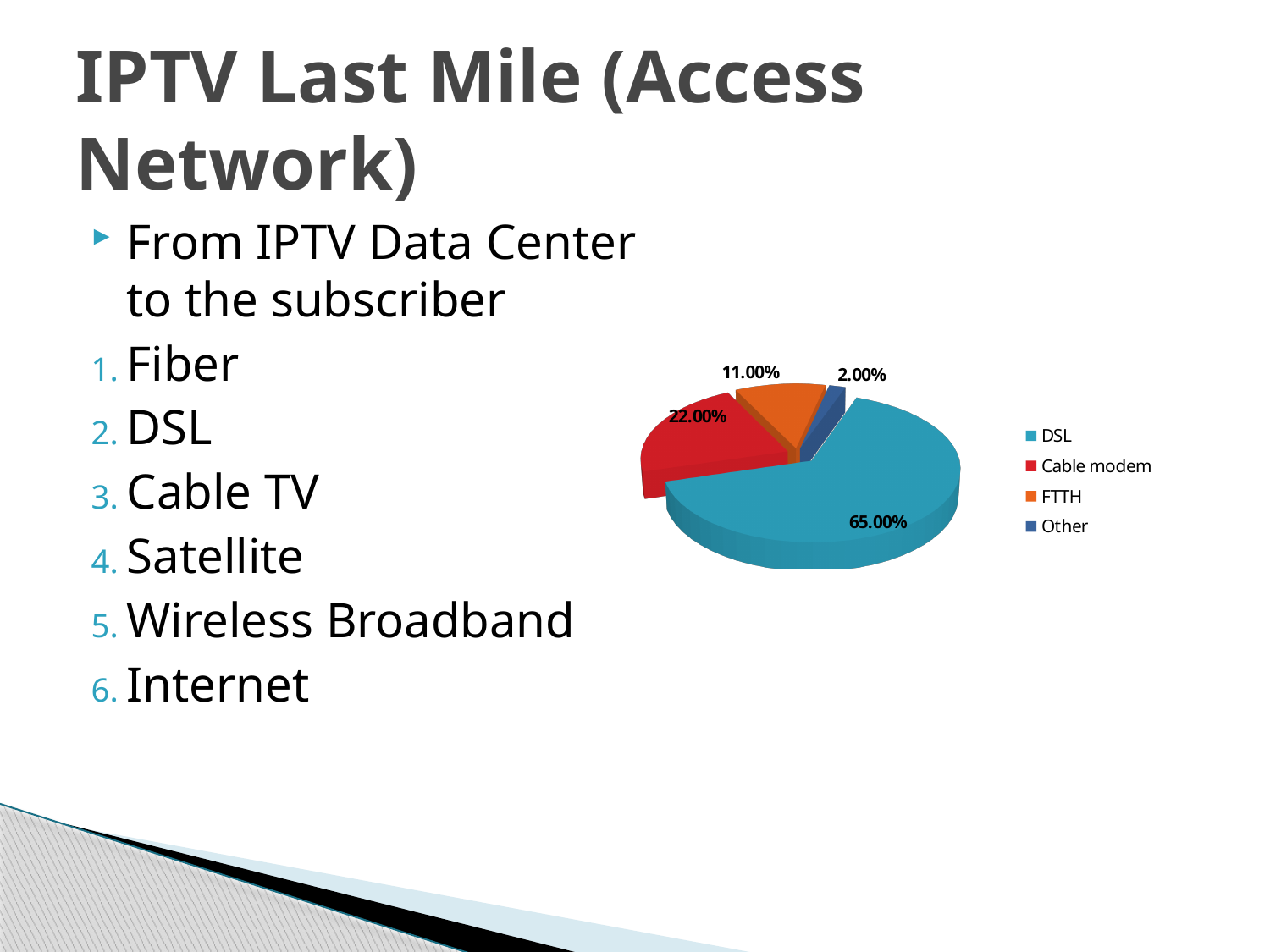
What share of the pie does Cable modem have? 22.00% What share of the pie does DSL have? 65.00% What share of the pie does FTTH have? 11.00% What type of chart is shown on the slide? Pie chart What is the combined share of FTTH and Other? 13.00% What is the difference in percentage points between DSL and Cable modem? 43.00% Which category has the largest slice of the pie? DSL What share of the pie does Other have? 2.00% What colour is the DSL slice in the pie chart? Blue Which category has the smallest slice of the pie? Other How many categories does the pie chart show? 4 Which is larger, the share for FTTH or the share for Cable modem? Cable modem